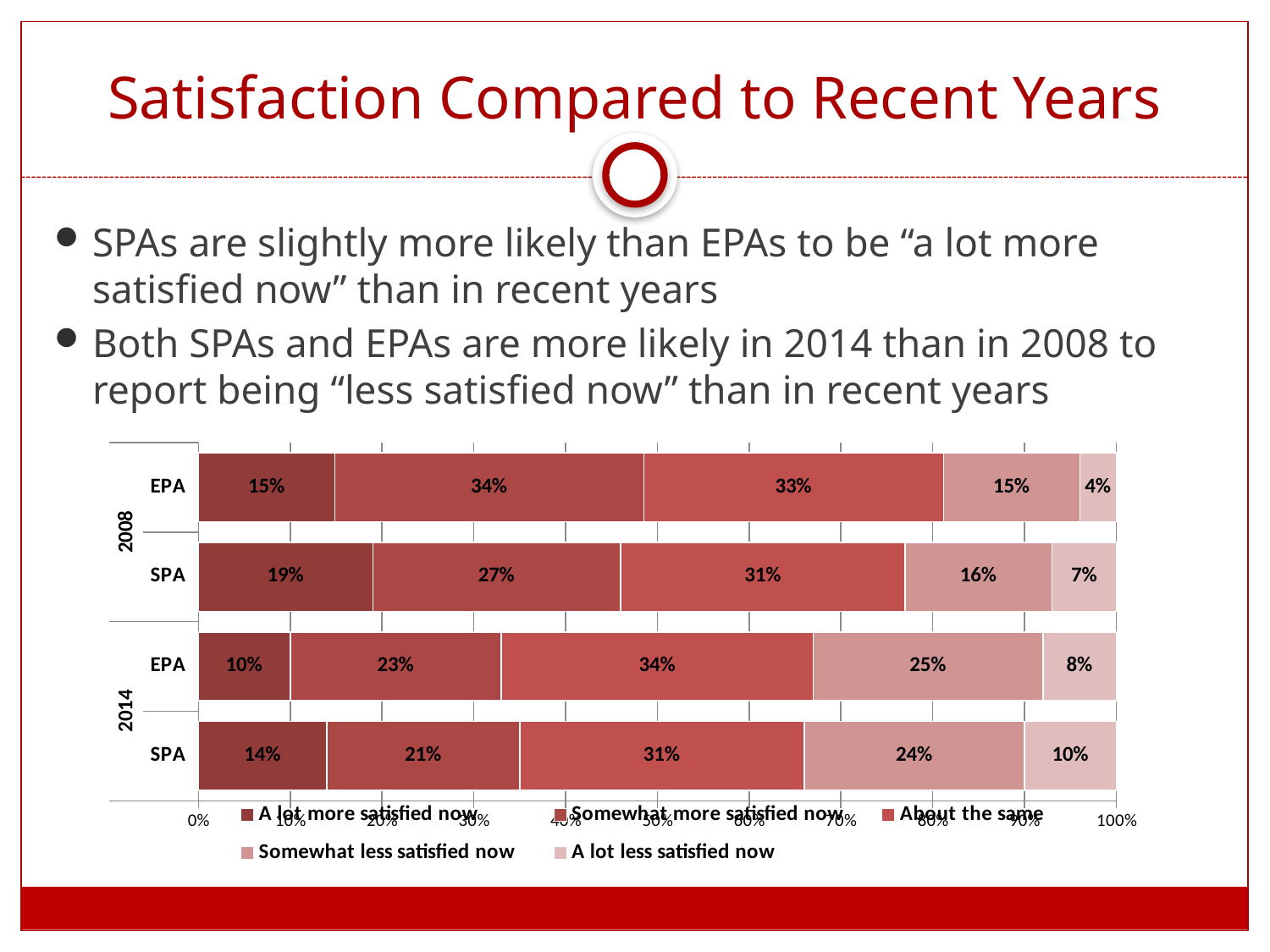
Which is larger: the "A lot more satisfied now" share for SPAs in 2014 or for EPAs in 2014? SPA 2014 What is the difference between the "Somewhat less satisfied now" share for EPAs in 2014 and EPAs in 2008? 10% What percentage of SPAs in 2008 were "A lot less satisfied now"? 7% What is the total of the 2014 SPA stacked bar? 100% Which group and year has the lowest share of "A lot less satisfied now"? EPA 2008 What kind of chart is shown on the slide? Stacked bar chart What percentage of EPAs in 2008 were "Somewhat more satisfied now"? 34% Which group and year has the highest share of "A lot more satisfied now"? SPA 2008 What percentage of EPAs in 2014 were "Somewhat less satisfied now"? 25% What percentage of SPAs in 2014 were "A lot more satisfied now"? 14% How many bars are plotted in the chart? 4 How many series does the legend list? 5